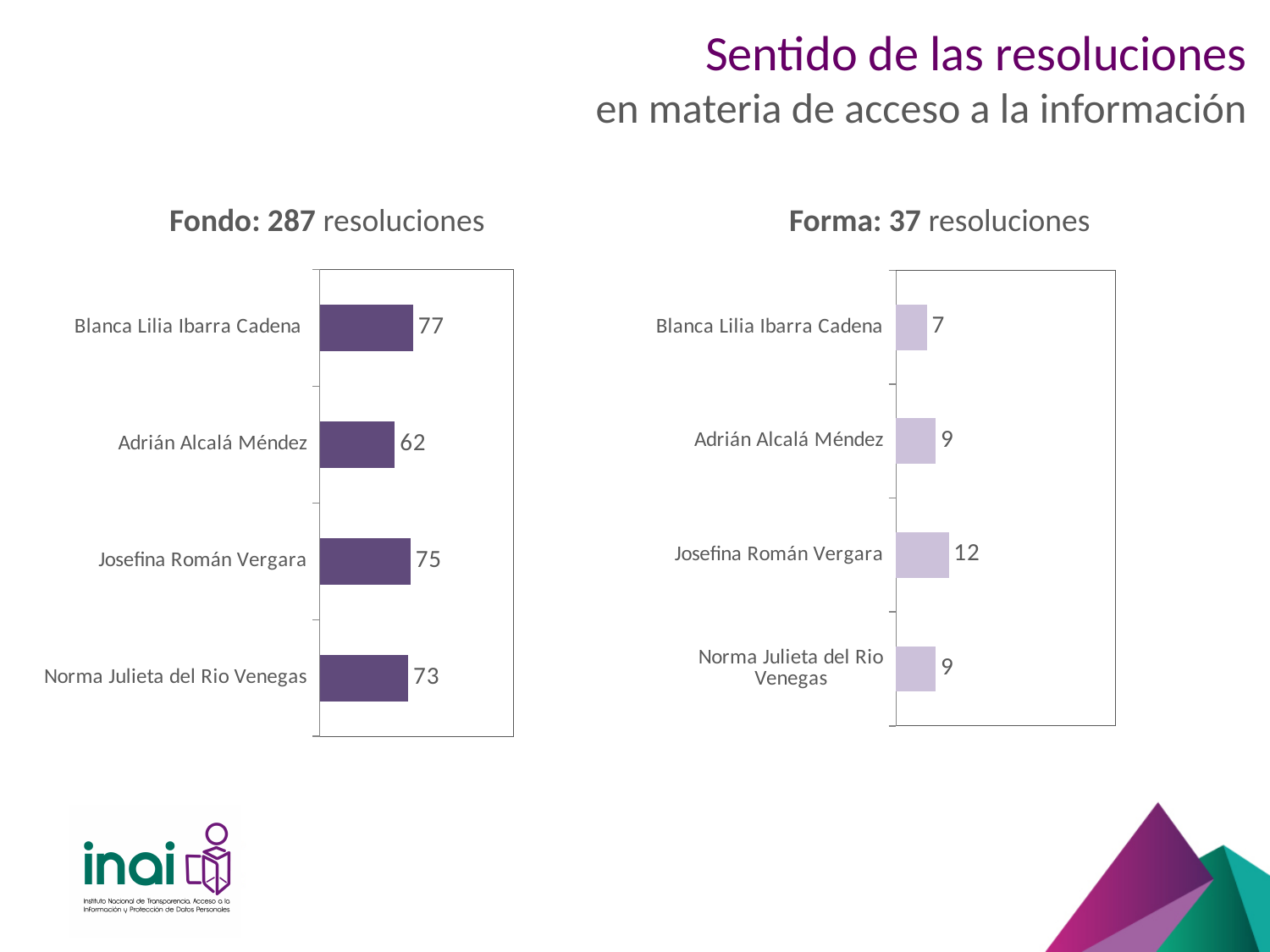
What kind of chart is the 'Forma: 37 resoluciones' chart? Bar chart In the 'Fondo: 287 resoluciones' chart, which commissioner has the lowest value? Adrián Alcalá Méndez In the 'Forma: 37 resoluciones' chart, which commissioner has the lowest value? Blanca Lilia Ibarra Cadena In the 'Fondo: 287 resoluciones' chart, what is the value for Blanca Lilia Ibarra Cadena? 77 How many categories are shown in the 'Fondo: 287 resoluciones' chart? 4 In the 'Forma: 37 resoluciones' chart, which commissioner has the highest value? Josefina Román Vergara What is the main title of the slide? Sentido de las resoluciones en materia de acceso a la información In the 'Fondo: 287 resoluciones' chart, what is the value for Norma Julieta del Rio Venegas? 73 In the 'Fondo: 287 resoluciones' chart, what is the difference between the values for Blanca Lilia Ibarra Cadena and Adrián Alcalá Méndez? 15 In the 'Forma: 37 resoluciones' chart, what is the difference between the values for Josefina Román Vergara and Blanca Lilia Ibarra Cadena? 5 In the 'Fondo: 287 resoluciones' chart, which is larger: the value for Josefina Román Vergara or Norma Julieta del Rio Venegas? Josefina Román Vergara In the 'Forma: 37 resoluciones' chart, what is the value for Josefina Román Vergara? 12